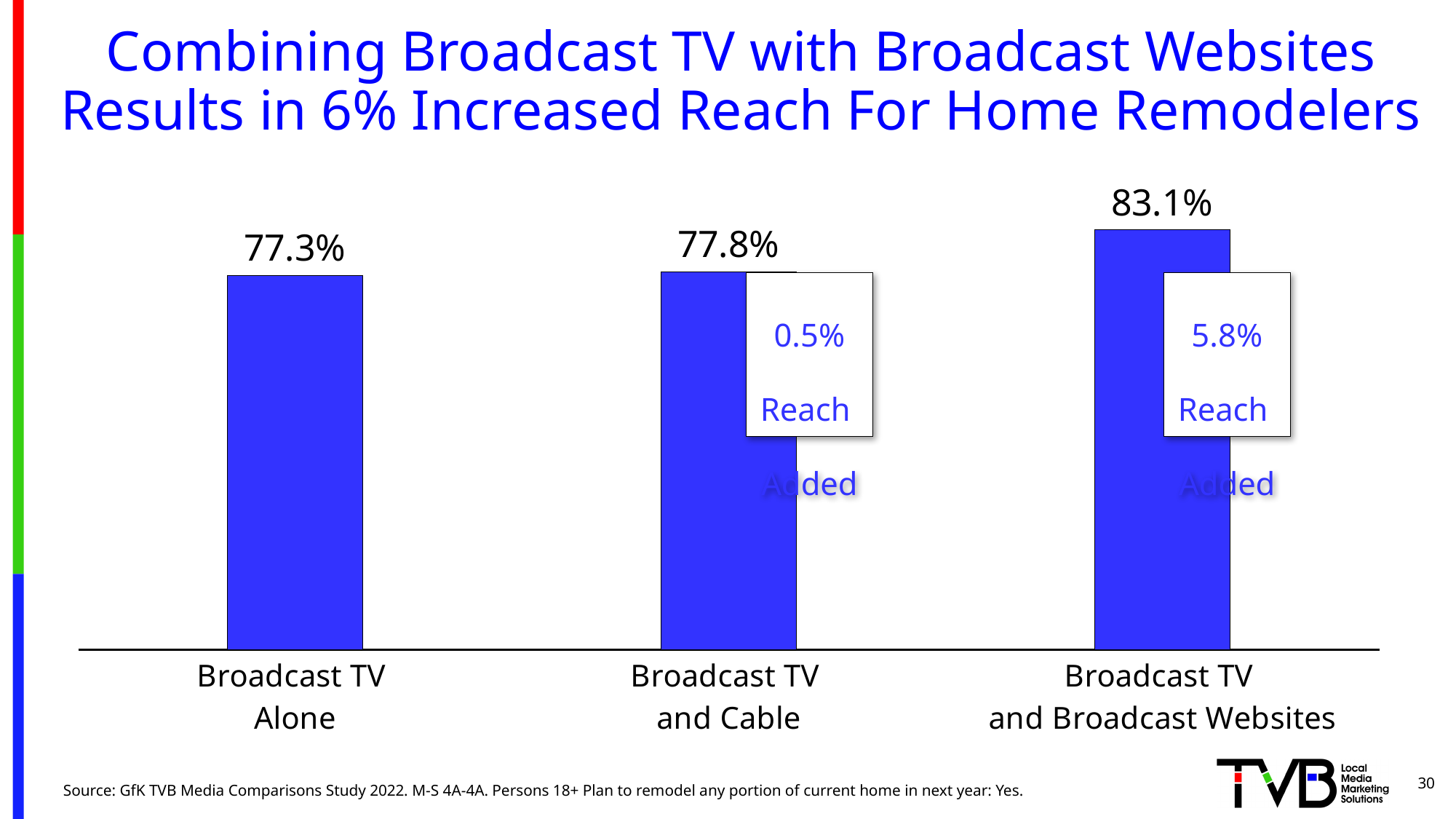
Which category has the lowest reach? Broadcast TV Alone What reach added is shown in the callout box for Broadcast TV and Broadcast Websites? 5.8% Reach Added What is the reach value for Broadcast TV and Broadcast Websites? 83.1% Do the values rise or fall from left to right across the categories? Rise Which is larger, the reach for Broadcast TV and Cable or the reach for Broadcast TV and Broadcast Websites? Broadcast TV and Broadcast Websites Which category has the highest reach? Broadcast TV and Broadcast Websites What is the difference in reach between Broadcast TV and Cable and Broadcast TV Alone? 0.5% What is the difference in reach between Broadcast TV and Broadcast Websites and Broadcast TV Alone? 5.8% How many categories are shown in the chart? 3 What is the reach value for Broadcast TV Alone? 77.3% What is the reach value for Broadcast TV and Cable? 77.8% What kind of chart is shown on the slide? Bar chart